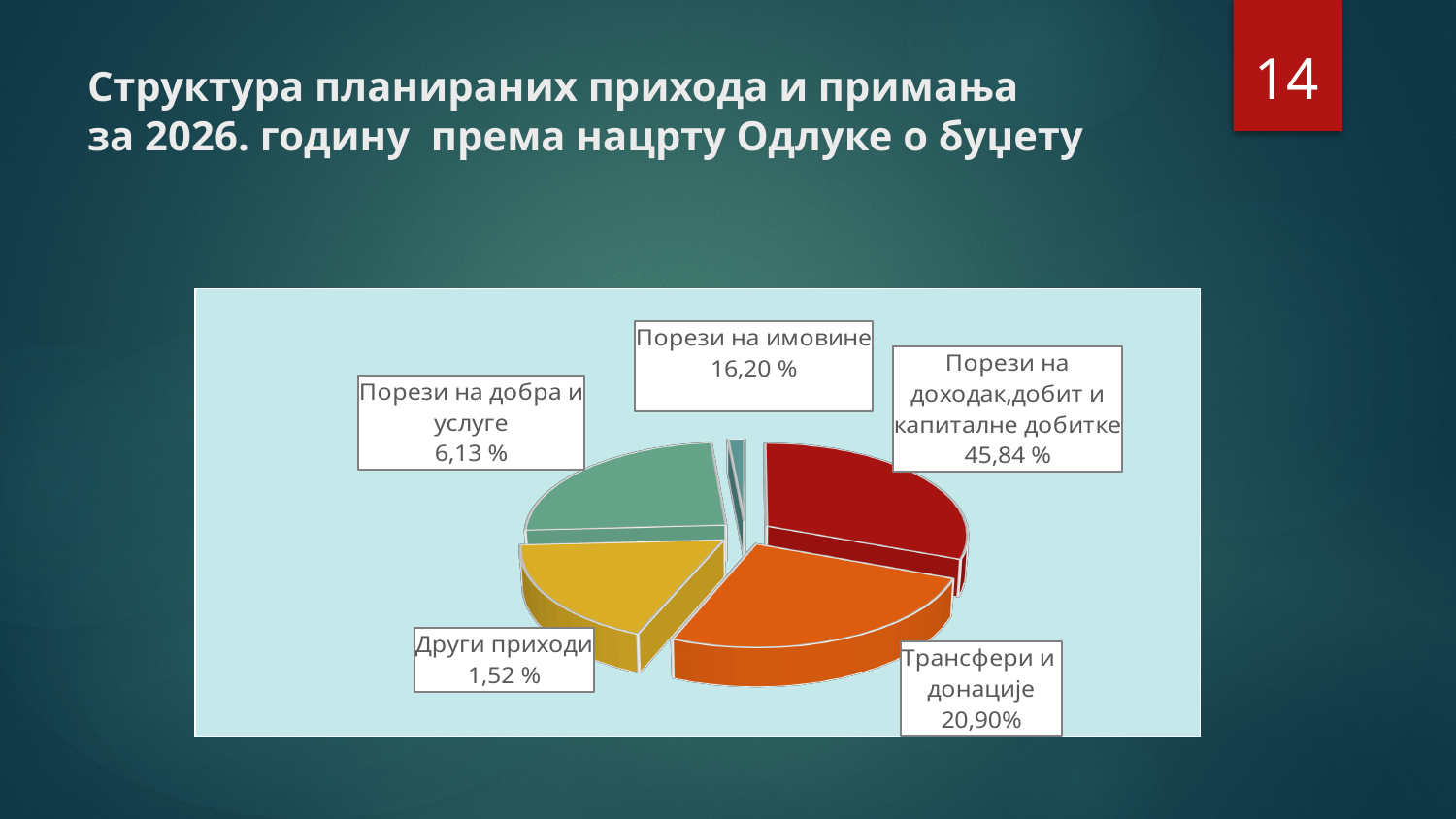
Which is larger, "Трансфери и донације" or "Порези на имовине"? Трансфери и донације What is the value shown for "Други приходи"? 1,52 % What is the value shown for "Порези на добра и услуге"? 6,13 % What is the value shown for "Трансфери и донације"? 20,90% Which labelled category has the largest share of the pie? Порези на доходак,добит и капиталне добитке What is the value shown for "Порези на имовине"? 16,20 % How many labelled categories are shown on the pie chart? 5 What is the difference between the values for "Порези на доходак,добит и капиталне добитке" and "Трансфери и донације"? 24,94 % What is the difference between the values for "Порези на имовине" and "Порези на добра и услуге"? 10,07 % Which labelled category has the smallest share of the pie? Други приходи What share of the pie does "Порези на доходак,добит и капиталне добитке" have? 45,84 % What kind of chart is shown on the slide? pie chart